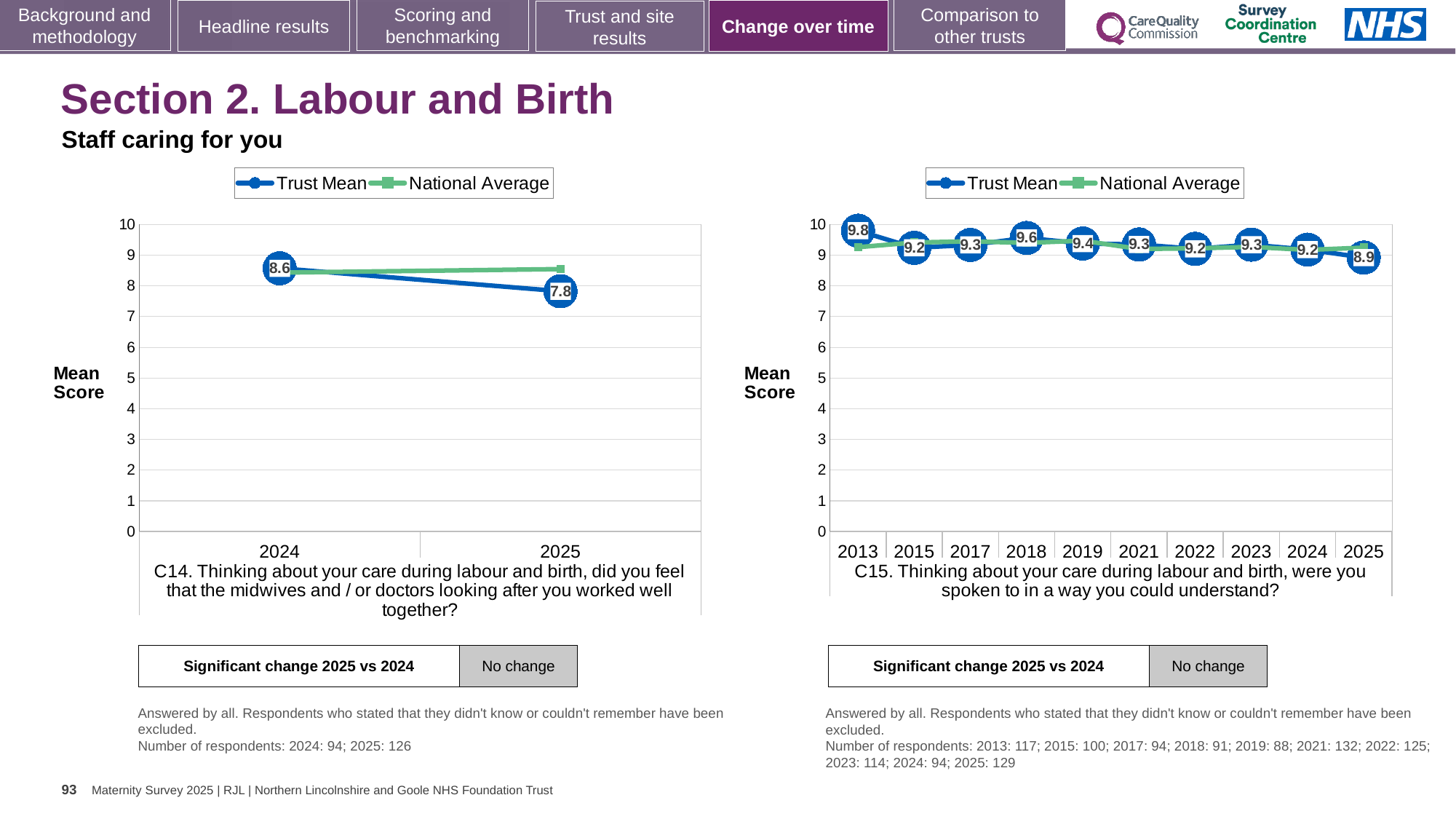
In the C14 chart on the left, what is the Trust Mean for 2024? 8.6 In the C15 chart on the right, which year has the highest Trust Mean? 2013 In the C14 chart on the left, is the National Average for 2025 greater or less than 8? greater In the C15 chart on the right, how many years are plotted on the x axis? 10 In the C15 chart on the right, is the Trust Mean higher in 2018 or in 2019? 2018 In the C15 chart on the right, what is the Trust Mean for 2013? 9.8 In the C15 chart on the right, which year has the lowest Trust Mean? 2025 In the C14 chart on the left, what is the Trust Mean for 2025? 7.8 How many series does the legend of the C14 chart on the left list? 2 In the C14 chart on the left, by how much did the Trust Mean fall from 2024 to 2025? 0.8 In the C14 chart on the left, does the Trust Mean rise or fall from 2024 to 2025? fall In the C15 chart on the right, what is the Trust Mean for 2025? 8.9